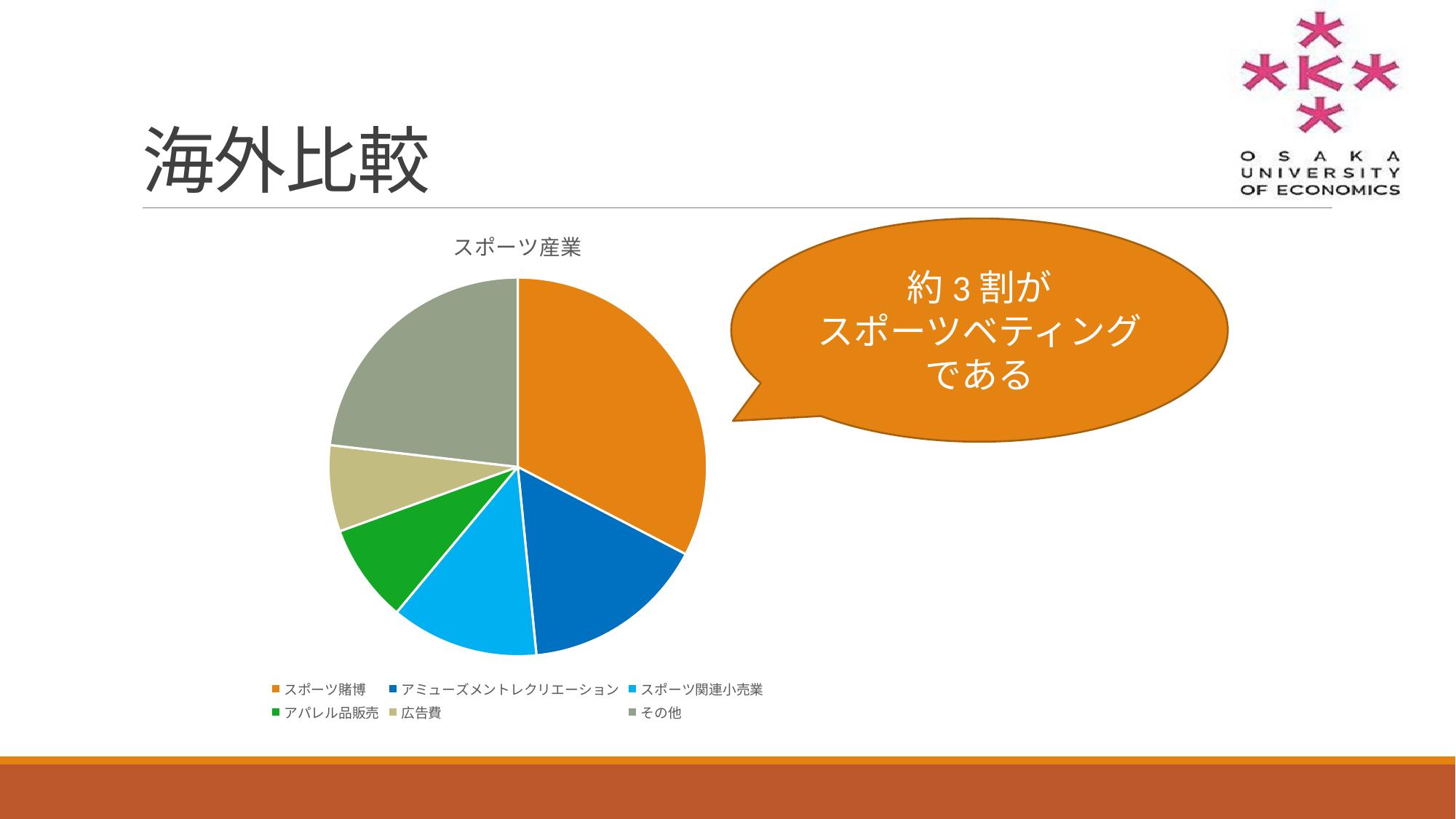
Which legend entry is shown in green in the pie chart? アパレル品販売 How many entries does the legend of the pie chart list? 6 Which slice is larger, その他 or アパレル品販売? その他 Which slice is larger, その他 or 広告費? その他 Which slice is larger, アミューズメントレクリエーション or スポーツ関連小売業? アミューズメントレクリエーション What is the title of the pie chart? スポーツ産業 Which category has the largest slice in the pie chart? スポーツ賭博 What kind of chart is shown on the slide? pie chart How many slices does the pie chart have? 6